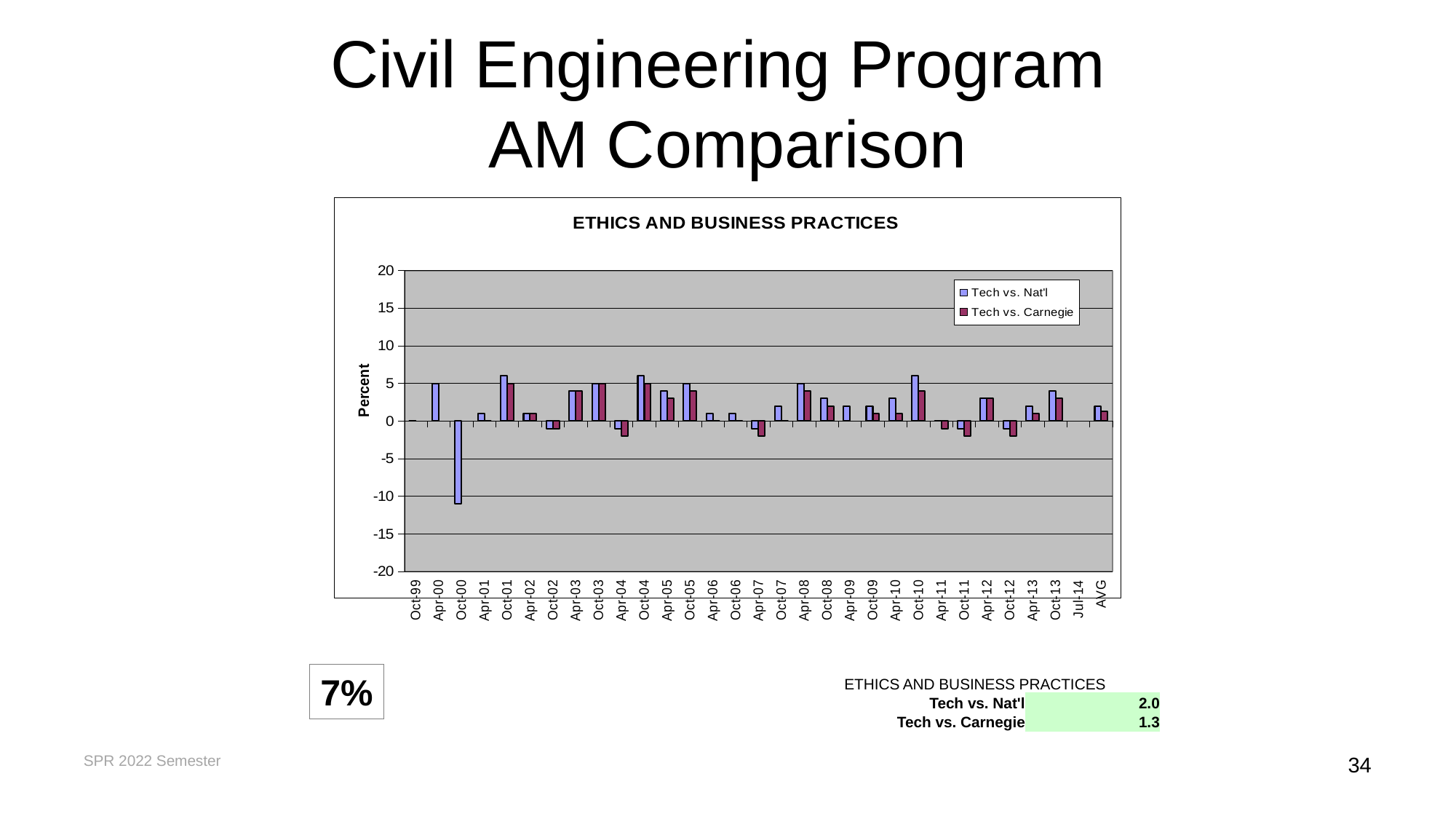
Is the Tech vs. Nat'l value for Oct-00 greater or less than -5? less What kind of chart is shown on the slide? Bar chart How many categories are shown along the x axis of the chart? 31 Which series has the larger AVG value, Tech vs. Nat'l or Tech vs. Carnegie? Tech vs. Nat'l What is the label on the chart's vertical axis? Percent How many series does the chart's legend list? 2 Which is larger, the Tech vs. Nat'l value for Apr-00 or for Oct-00? Apr-00 What is the difference between the AVG values for Tech vs. Nat'l and Tech vs. Carnegie? 0.7 Which category has the lowest Tech vs. Nat'l value? Oct-00 What is the AVG value for Tech vs. Carnegie? 1.3 What is the AVG value for Tech vs. Nat'l? 2.0 What is the title of the chart? ETHICS AND BUSINESS PRACTICES